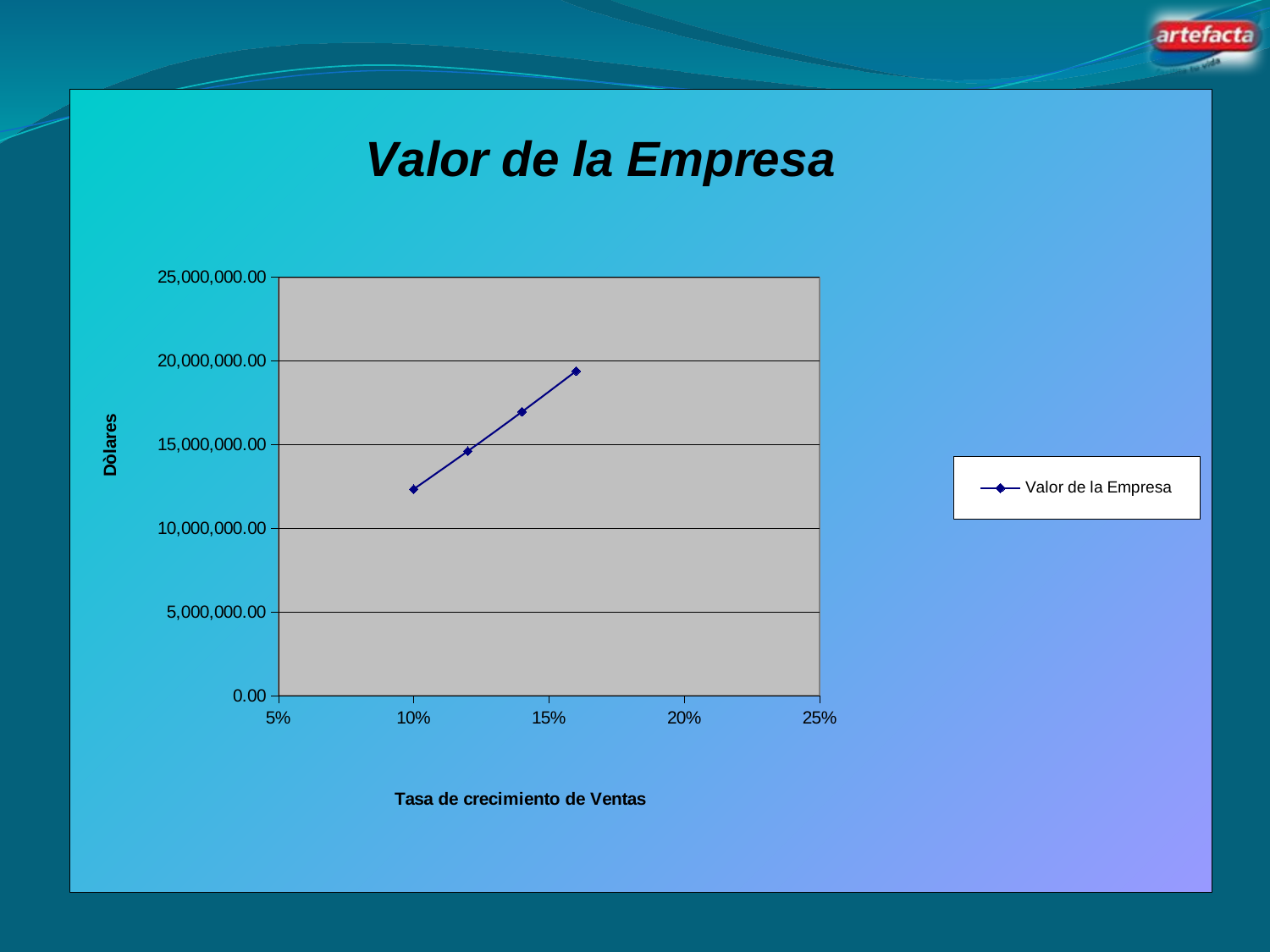
Is the value for a 10% sales growth rate greater or less than 15,000,000.00? less Does the value of the company rise or fall as the sales growth rate increases? rise What kind of chart is shown on the slide? line chart At which sales growth rate shown on the x axis is the plotted value lowest? 10% How many data points are plotted on the line? 4 Is the highest plotted value greater or less than 15,000,000.00? greater Is the value for a 10% sales growth rate greater or less than 10,000,000.00? greater How many series does the legend list? 1 Is the value at the leftmost point larger or smaller than the value at the rightmost point? smaller What is the label of the x axis? Tasa de crecimiento de Ventas What is the title of the chart? Valor de la Empresa